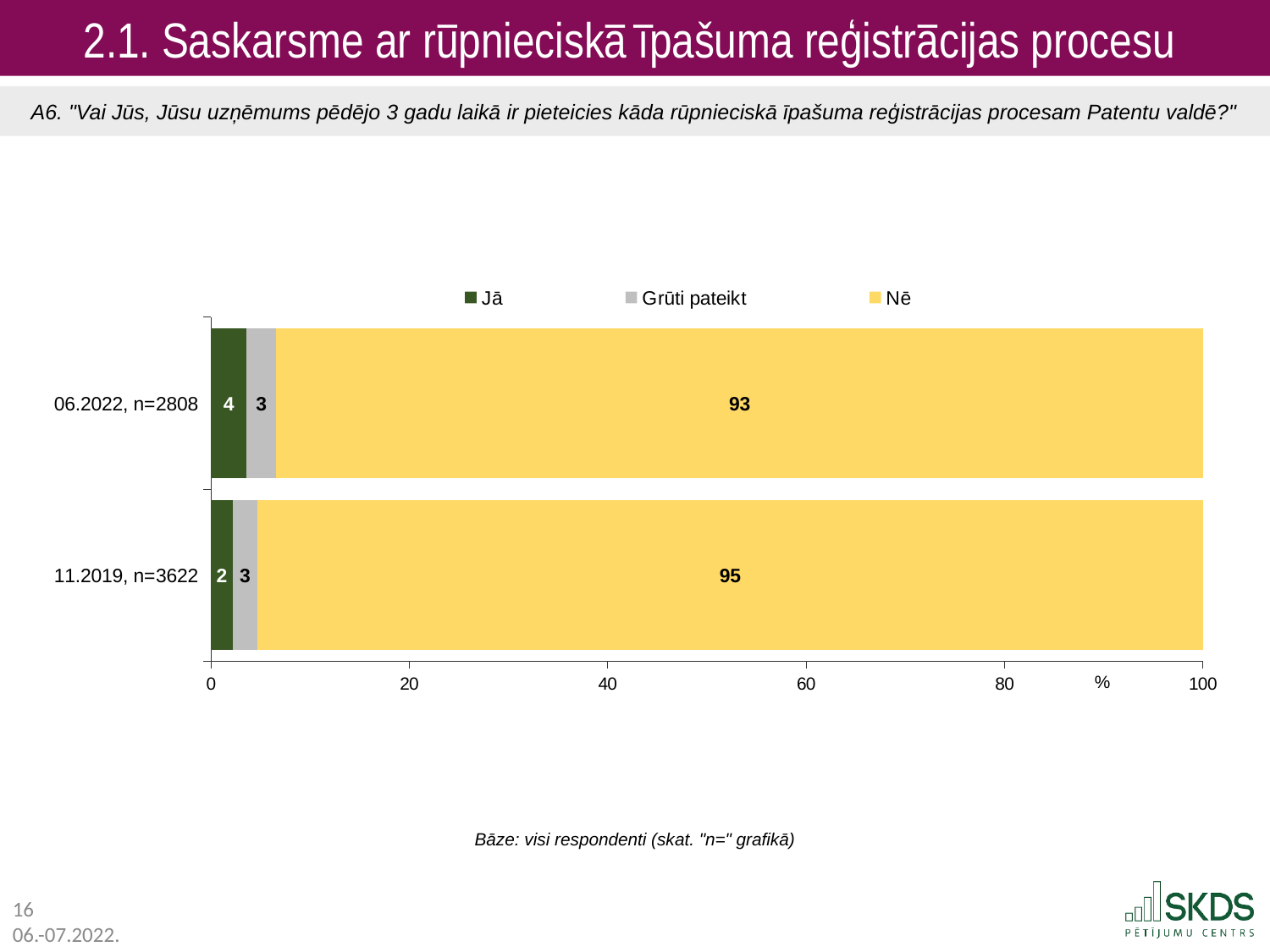
What is the difference between the "Nē" values for 11.2019 and 06.2022? 2 What is the total of the 06.2022, n=2808 stacked bar? 100 What is the value for "Jā" in the 11.2019, n=3622 bar? 2 How many series does the legend list? 3 What is the difference between the "Jā" values for 06.2022 and 11.2019? 2 What is the value for "Nē" in the 06.2022, n=2808 bar? 93 What is the value for "Nē" in the 11.2019, n=3622 bar? 95 What is the value for "Grūti pateikt" in the 06.2022, n=2808 bar? 3 How many bars (categories) are shown in the chart? 2 Which legend entry is shown in yellow? Nē Which bar has the higher value for "Nē", 06.2022 or 11.2019? 11.2019, n=3622 What kind of chart is shown on the slide? Stacked bar chart